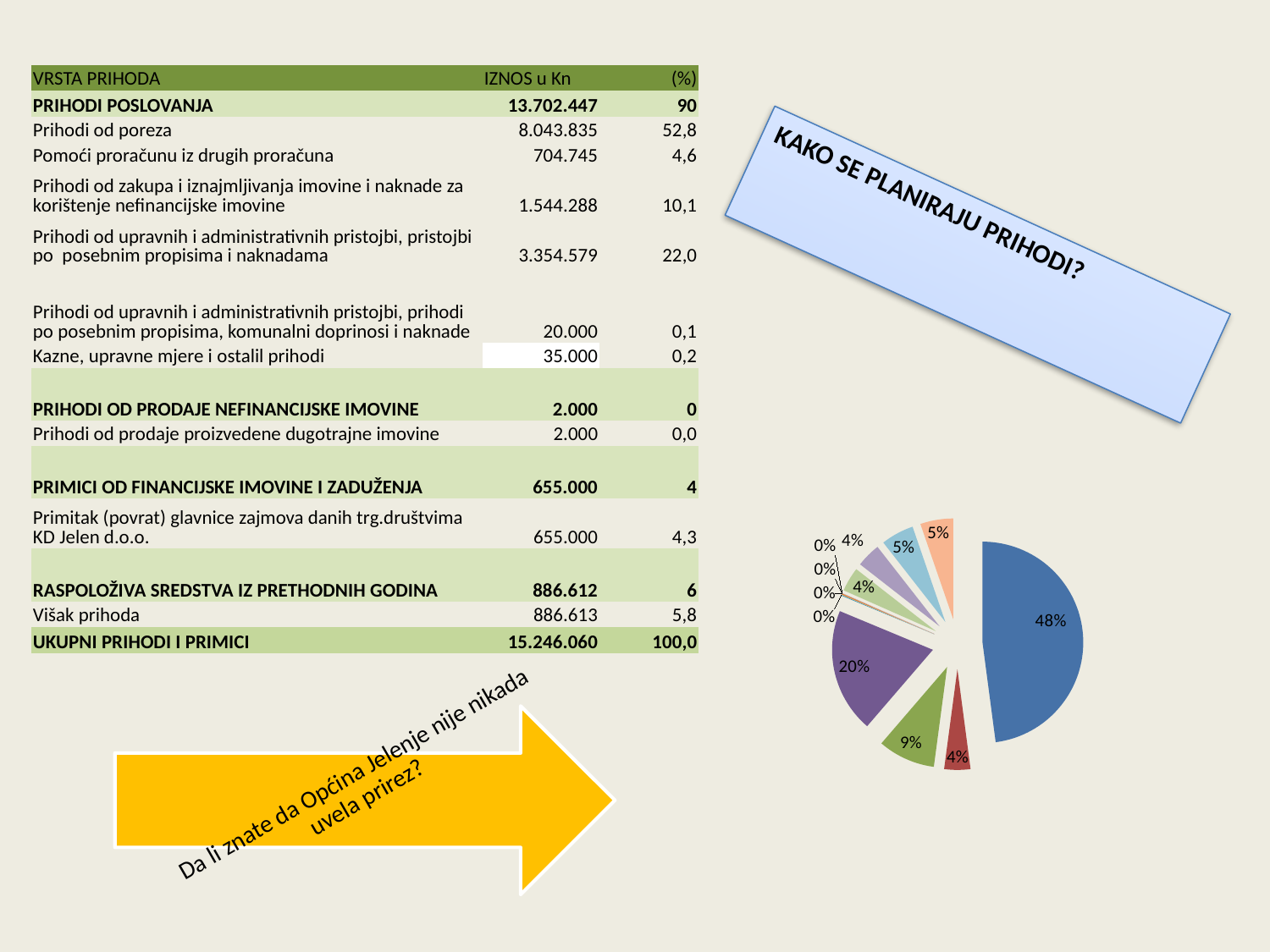
In the pie chart, which slice is larger, the blue slice or the purple slice? the blue slice What is the smallest percentage labelled on the pie chart? 0% In the pie chart, what share does the dark red slice next to the blue slice have? 4% What is the largest percentage labelled on the pie chart? 48% In the pie chart, what share does the largest slice (the blue one) have? 48% In the pie chart, what is the difference in percentage points between the purple slice (20%) and the green slice (9%)? 11 In the pie chart, what share does the green slice have? 9% What kind of chart is shown on the right side of the slide? pie chart In the pie chart, what is the difference in percentage points between the blue slice (48%) and the purple slice (20%)? 28 Does the pie chart display a legend? No Does the pie chart have a title? No